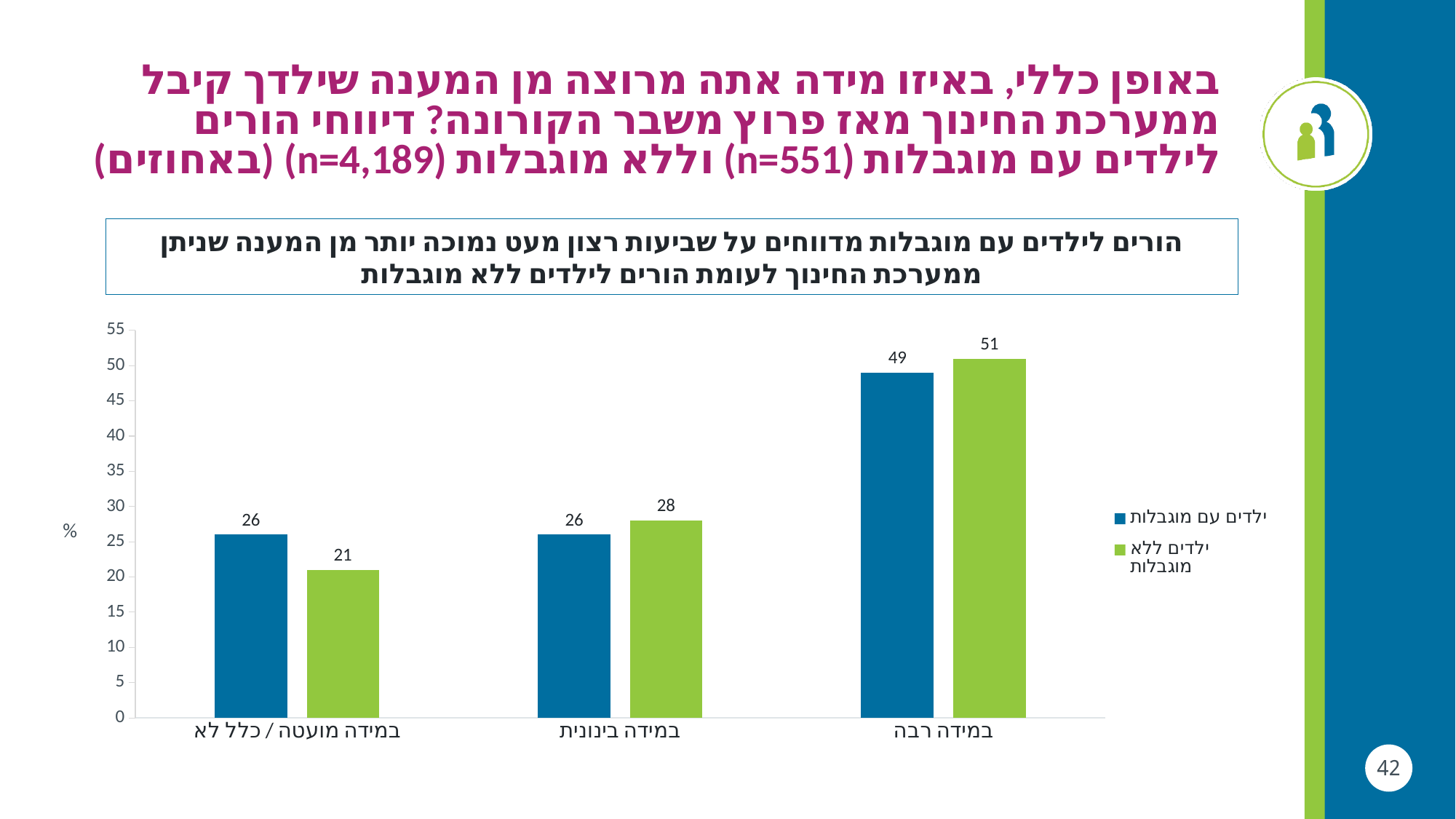
In the category במידה בינונית, which series has the larger value, ילדים עם מוגבלות or ילדים ללא מוגבלות? ילדים ללא מוגבלות Which colour represents the series ילדים עם מוגבלות in the legend? blue What is the value for ילדים עם מוגבלות in the category במידה רבה? 49 Which category has the highest value for ילדים ללא מוגבלות? במידה רבה What is the value for ילדים ללא מוגבלות in the category במידה מועטה / כלל לא? 21 Which category has the lowest value for ילדים ללא מוגבלות? במידה מועטה / כלל לא How many series does the legend list? 2 What is the difference between ילדים עם מוגבלות and ילדים ללא מוגבלות in the category במידה מועטה / כלל לא? 5 What kind of chart is shown on the slide? bar chart What is the value for ילדים עם מוגבלות in the category במידה בינונית? 26 How many categories are shown on the x axis? 3 What is the value for ילדים ללא מוגבלות in the category במידה רבה? 51